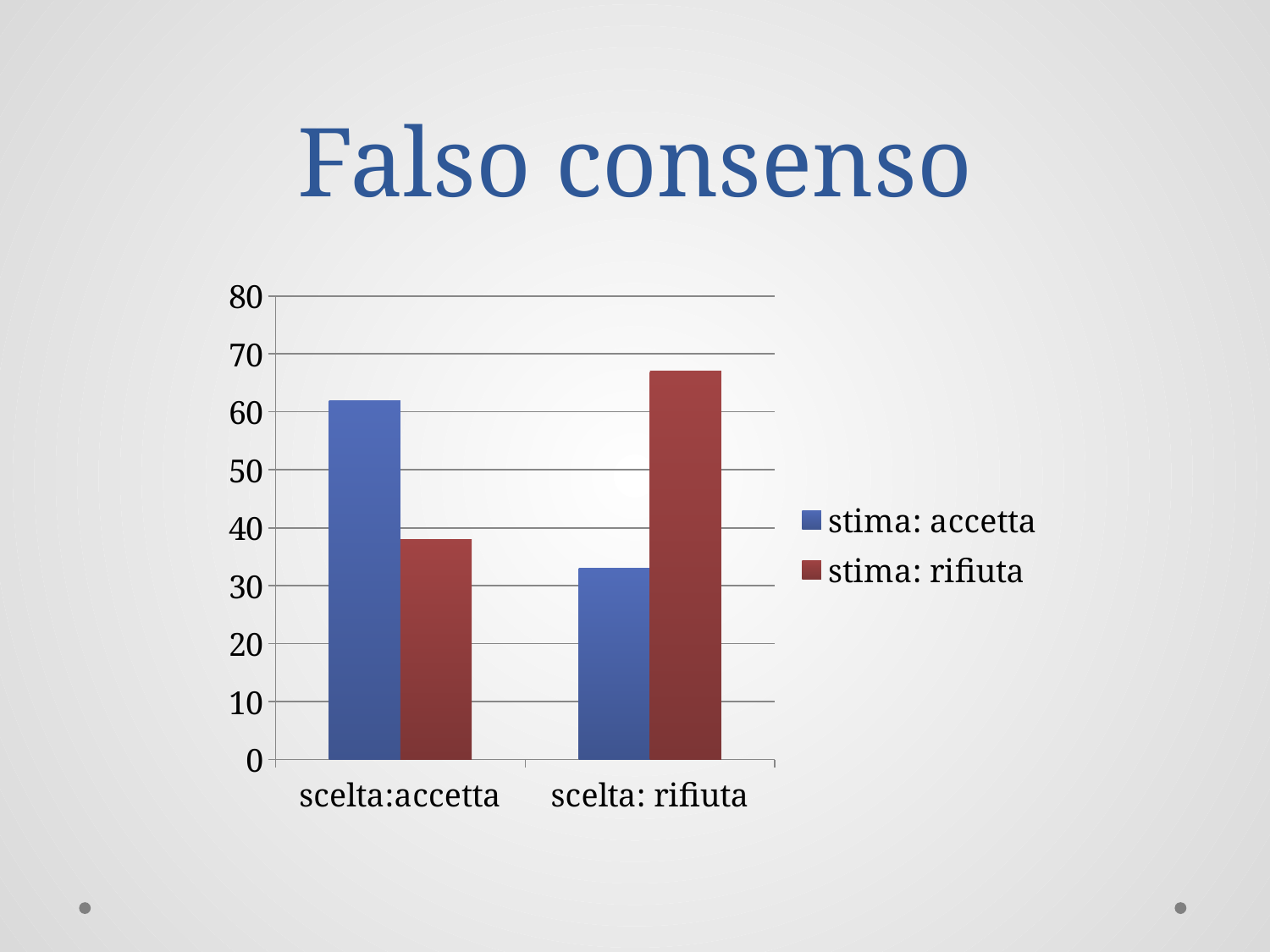
For the category 'scelta:accetta', which series has the larger value? stima: accetta Which bar in the chart is the shortest? stima: accetta for scelta: rifiuta How many categories are shown on the x axis of the chart? 2 Is the value of 'stima: rifiuta' for 'scelta:accetta' greater or less than 40? less Is the value of 'stima: rifiuta' for 'scelta: rifiuta' greater or less than 70? less What kind of chart is shown on the slide? bar chart Which bar in the chart is the tallest? stima: rifiuta for scelta: rifiuta How many series does the chart's legend list? 2 Is the value of 'stima: accetta' for 'scelta:accetta' greater or less than 60? greater For the category 'scelta: rifiuta', which series has the larger value? stima: rifiuta What is the title of the slide containing the chart? Falso consenso